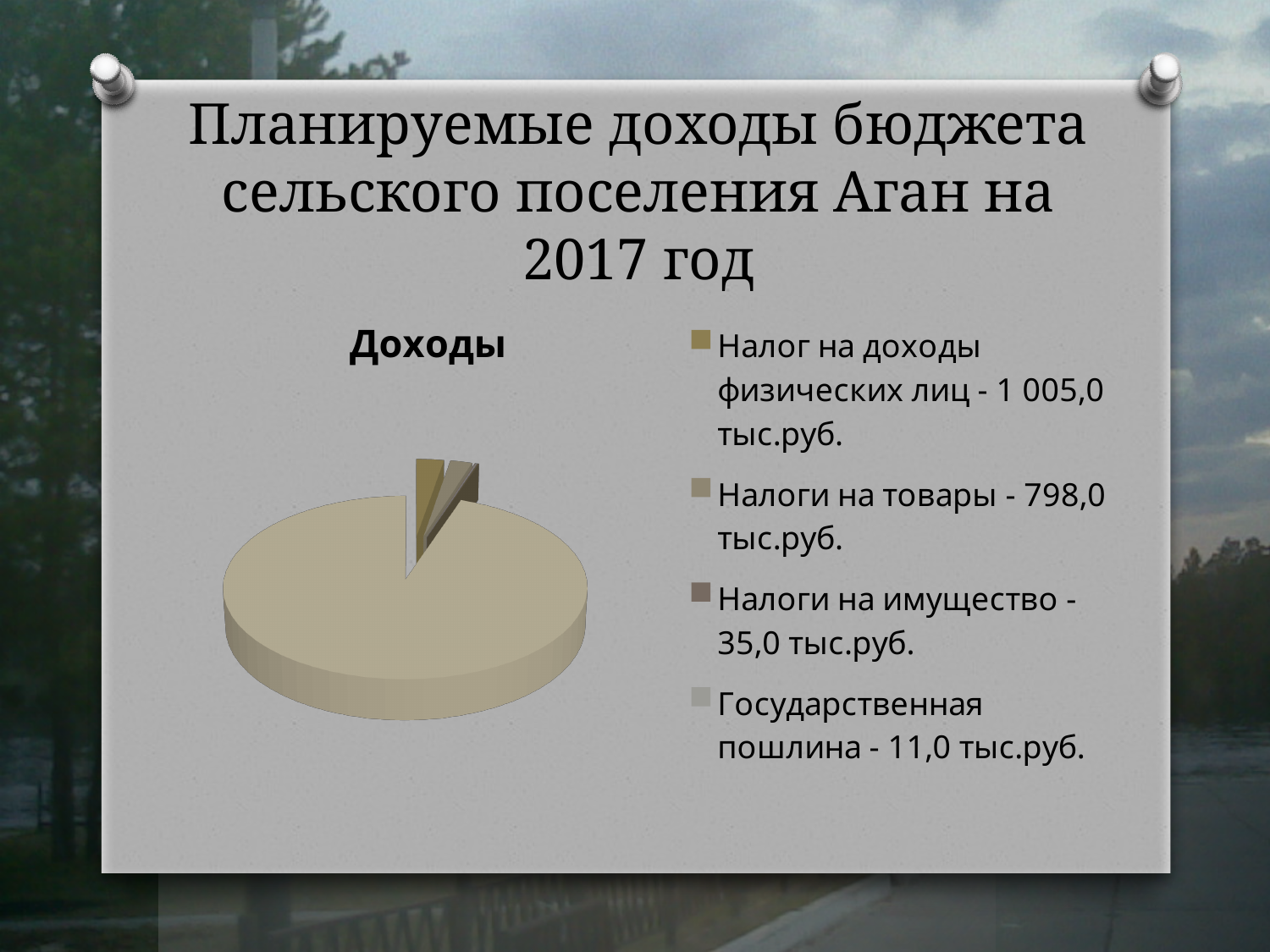
What is the title of the pie chart? Доходы Which is larger: Налоги на товары or Налоги на имущество? Налоги на товары Which category has the largest planned value according to the legend? Налог на доходы физических лиц What is the planned value for Налоги на имущество? 35,0 тыс.руб. What is the difference between Налог на доходы физических лиц and Налоги на товары? 207,0 тыс.руб. What is the planned value for Налог на доходы физических лиц? 1 005,0 тыс.руб. What type of chart is shown on the slide? pie chart What is the planned value for Налоги на товары? 798,0 тыс.руб. What is the difference between Налоги на имущество and Государственная пошлина? 24,0 тыс.руб. What is the planned value for Государственная пошлина? 11,0 тыс.руб. How many categories does the pie chart's legend list? 4 Which category has the smallest planned value according to the legend? Государственная пошлина